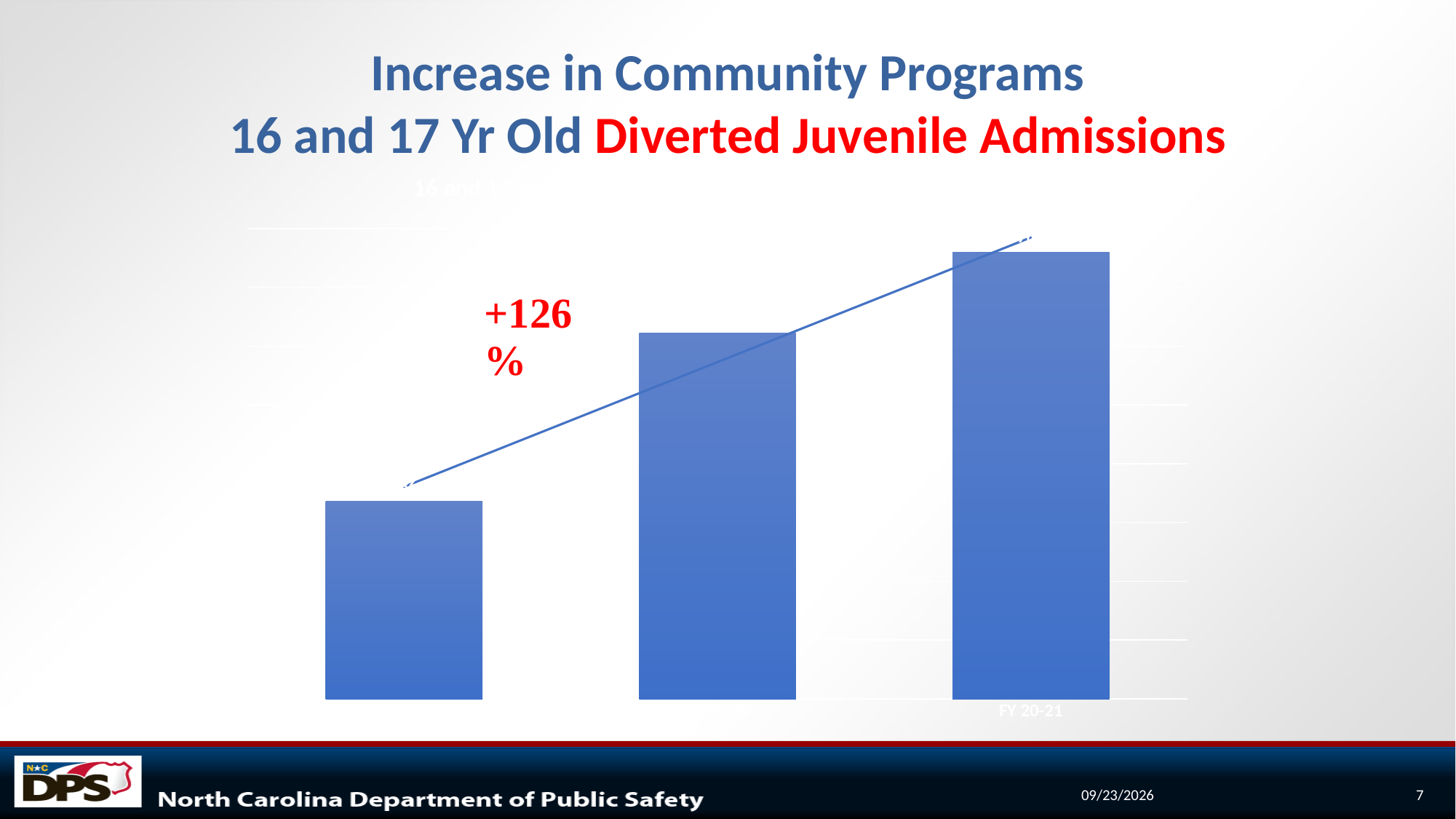
How many bars are plotted in the chart? 3 What percentage change is annotated in red on the chart? +126% Is the middle bar taller or shorter than the leftmost bar? taller Which fiscal year label appears under the rightmost bar? FY 20-21 Do the bar values rise or fall from left to right across the chart? rise Is the rightmost bar (FY 20-21) taller or shorter than the middle bar? taller Which bar is the shortest in the chart? the leftmost bar Which bar is the tallest in the chart? the rightmost bar (FY 20-21) What kind of chart is shown on the slide? bar chart